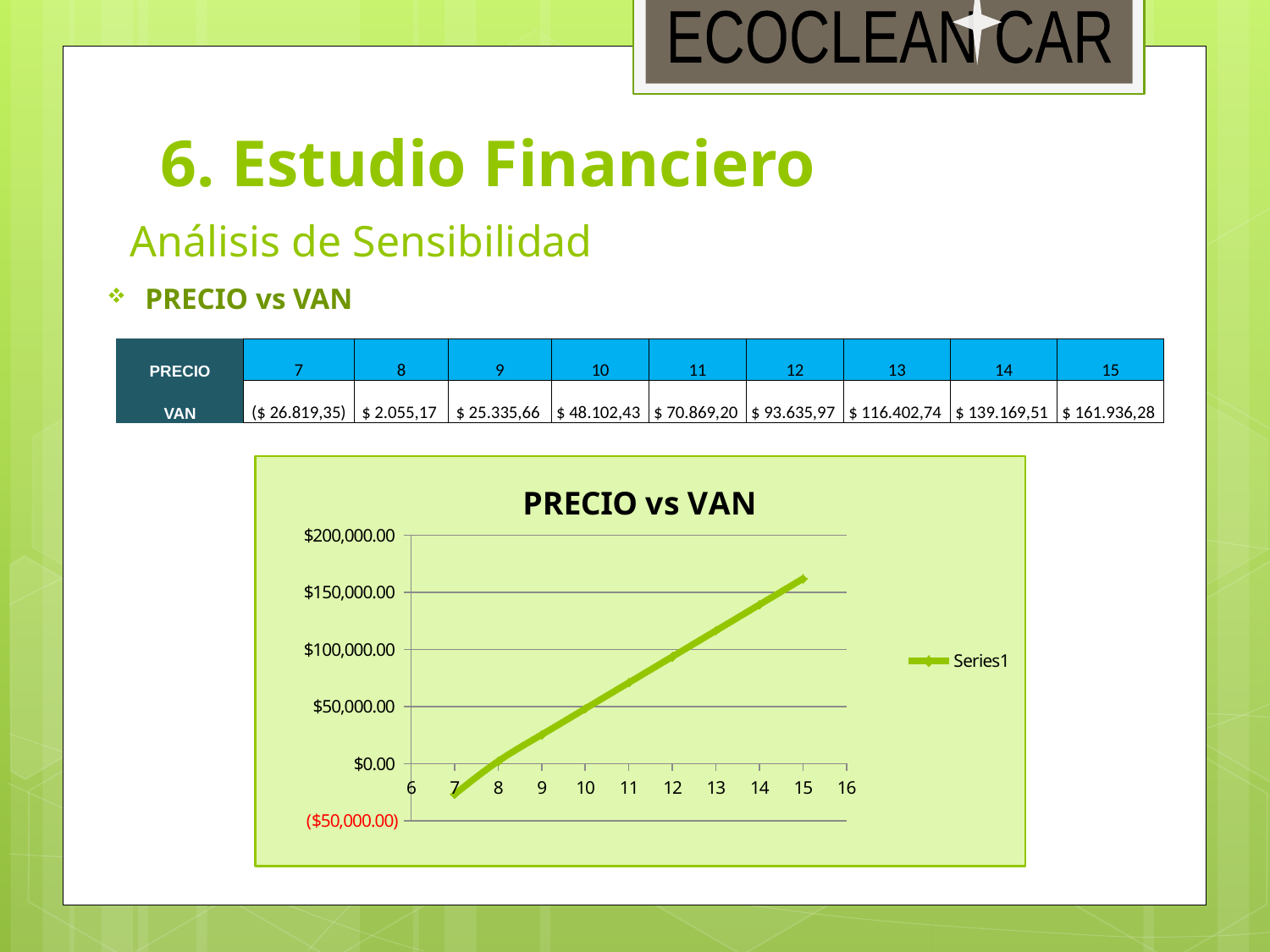
How many series does the legend of the "PRECIO vs VAN" chart list? 1 According to the PRECIO vs VAN table on the slide, what is the VAN when PRECIO is 11? $ 70.869,20 In the "PRECIO vs VAN" chart, is the VAN at PRECIO 13 greater or less than $100,000.00? greater Which is larger in the "PRECIO vs VAN" chart: the VAN at PRECIO 9 or the VAN at PRECIO 14? PRECIO 14 What type of chart is shown under the title "PRECIO vs VAN"? line chart In the "PRECIO vs VAN" chart, is the VAN at PRECIO 7 greater or less than $0.00? less At which PRECIO is the VAN highest in the "PRECIO vs VAN" chart? 15 What is the name of the series shown in the legend of the "PRECIO vs VAN" chart? Series1 At which PRECIO is the VAN lowest in the "PRECIO vs VAN" chart? 7 How many data points are plotted on the "PRECIO vs VAN" line? 9 Does the VAN rise or fall as PRECIO increases along the x axis of the "PRECIO vs VAN" chart? rise In the "PRECIO vs VAN" chart, is the VAN at PRECIO 15 greater or less than $150,000.00? greater